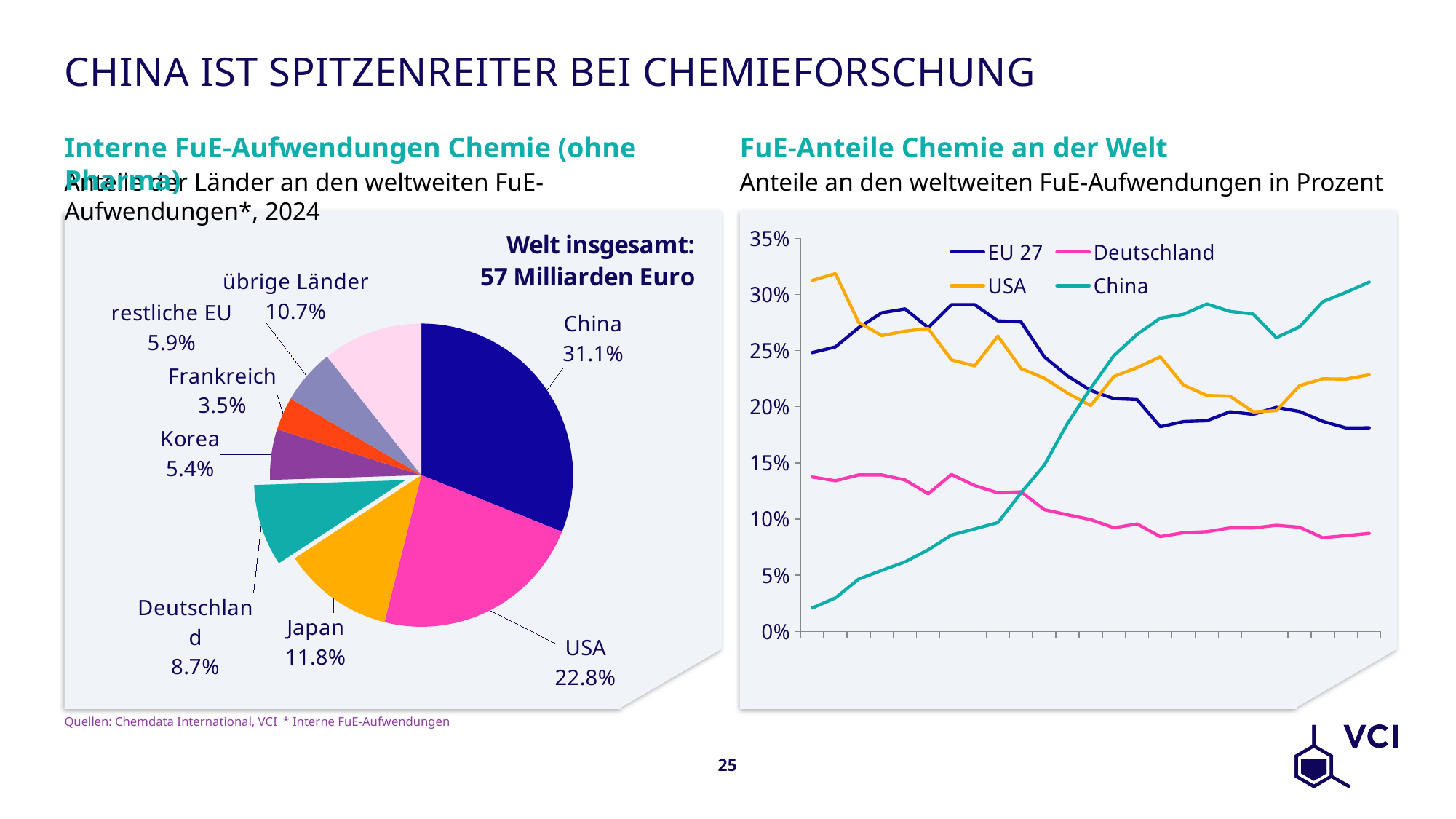
On the line chart on the right, does the China series rise or fall along the x axis? rise On the pie chart on the left, which labelled slice has the smallest share? Frankreich On the pie chart on the left, what is the difference between the shares of China and the USA? 8.3% On the pie chart on the left, which is larger: the share of Korea or the share of restliche EU? restliche EU What is the world total stated on the pie chart on the left? 57 Milliarden Euro On the pie chart on the left, what share does Japan have? 11.8% On the line chart on the right, is the final value for Deutschland greater or less than 10%? less How many series does the legend of the line chart on the right list? 4 On the pie chart on the left, what share does China have? 31.1% What kind of chart is the chart on the right, 'FuE-Anteile Chemie an der Welt'? line chart On the pie chart on the left, which country has the largest share? China How many slices does the pie chart on the left have? 8